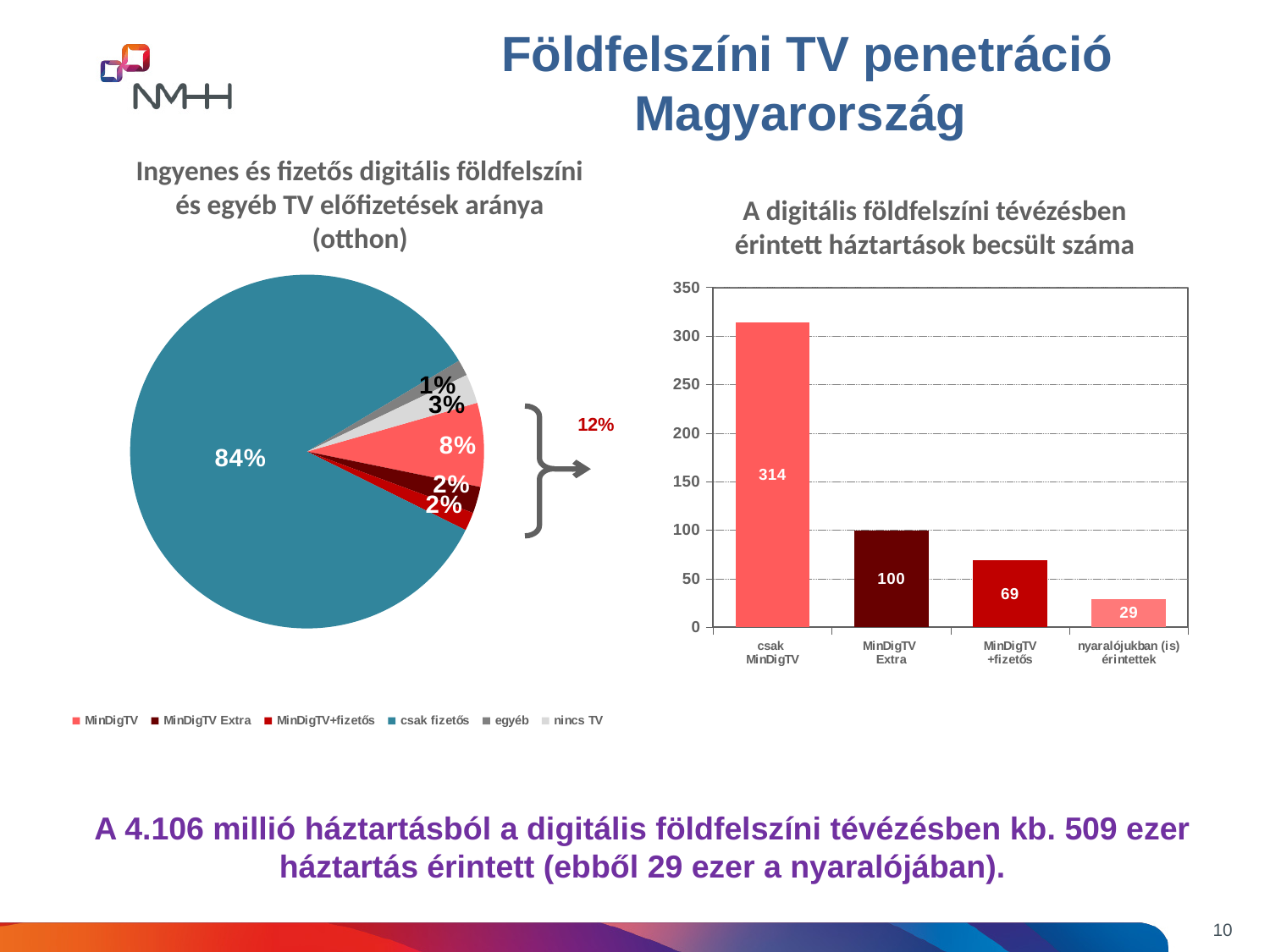
In the bar chart on the right, which is larger: MinDigTV Extra or MinDigTV +fizetős? MinDigTV Extra In the bar chart on the right, what is the value for nyaralójukban (is) érintettek? 29 How many categories are shown in the bar chart on the right? 4 In the bar chart on the right, what is the value for MinDigTV Extra? 100 In the bar chart on the right, which category has the highest value? csak MinDigTV In the pie chart on the left, what share does csak fizetős have? 84% How many entries does the legend of the pie chart on the left list? 6 In the bar chart on the right, which category has the lowest value? nyaralójukban (is) érintettek In the bar chart 'A digitális földfelszíni tévézésben érintett háztartások becsült száma', what is the value for csak MinDigTV? 314 In the bar chart on the right, what is the difference between the values for csak MinDigTV and MinDigTV Extra? 214 What type of chart is the chart on the right of the slide? bar chart In the pie chart on the left, what share does MinDigTV have? 8%